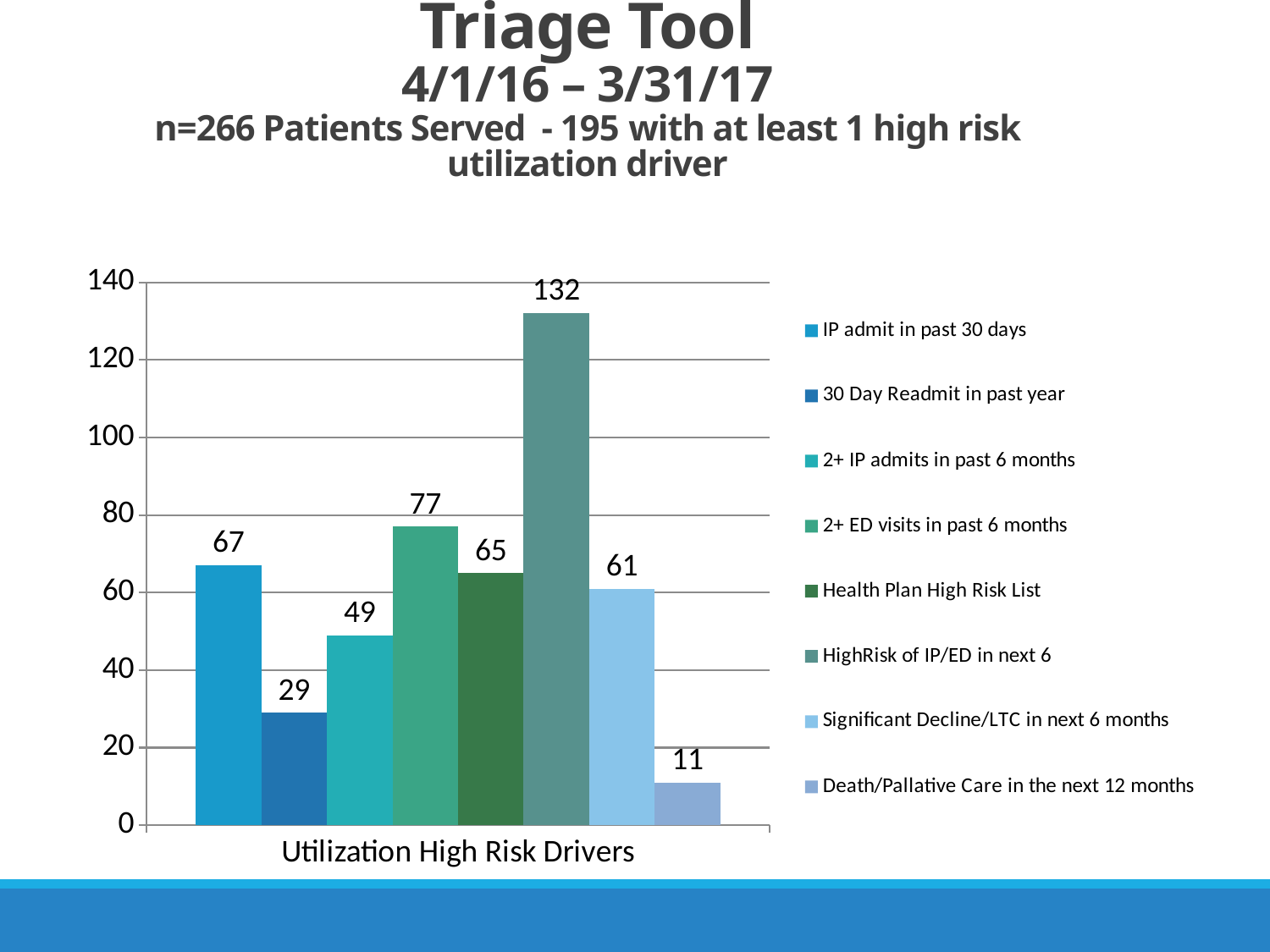
How many series does the legend list? 8 What is the x-axis label of the chart? Utilization High Risk Drivers Which is larger: 'IP admit in past 30 days' or '2+ IP admits in past 6 months'? IP admit in past 30 days Which series has the highest value? HighRisk of IP/ED in next 6 What is the value for '30 Day Readmit in past year'? 29 What is the difference between the values for 'IP admit in past 30 days' and 'Death/Pallative Care in the next 12 months'? 56 What is the value for 'HighRisk of IP/ED in next 6'? 132 What kind of chart is shown on the slide? bar chart Is the value for 'HighRisk of IP/ED in next 6' greater or less than 120? greater Which series has the lowest value? Death/Pallative Care in the next 12 months What is the value for 'Significant Decline/LTC in next 6 months'? 61 What is the difference between the values for '2+ ED visits in past 6 months' and 'Health Plan High Risk List'? 12